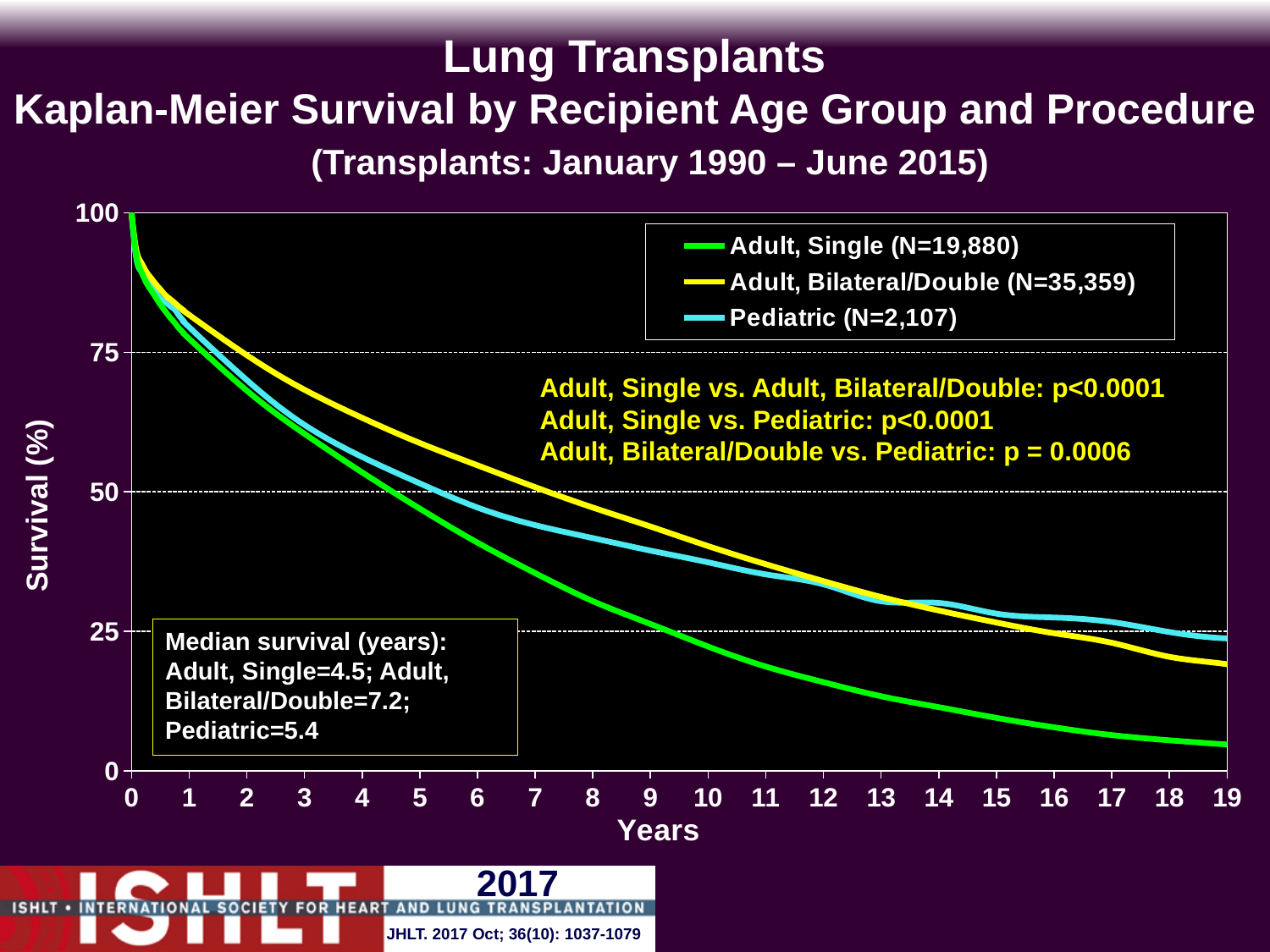
Which group has the lowest median survival? Adult, Single Is the survival value for Adult, Single at 12 years greater or less than 25? less What is the median survival in years for the Pediatric group? 5.4 What kind of chart is shown on the slide? Line chart What is the difference in median survival (years) between Adult, Bilateral/Double and Adult, Single? 2.7 According to the legend, what is the N for the Adult, Single group? 19,880 How many series does the legend list? 3 Is the survival value for Adult, Bilateral/Double at 5 years greater or less than 50? greater Which group has the highest median survival? Adult, Bilateral/Double What is the median survival in years for the Adult, Bilateral/Double group? 7.2 At 15 years, which curve shows higher survival: Pediatric or Adult, Single? Pediatric Do the survival curves rise or fall as years increase? Fall